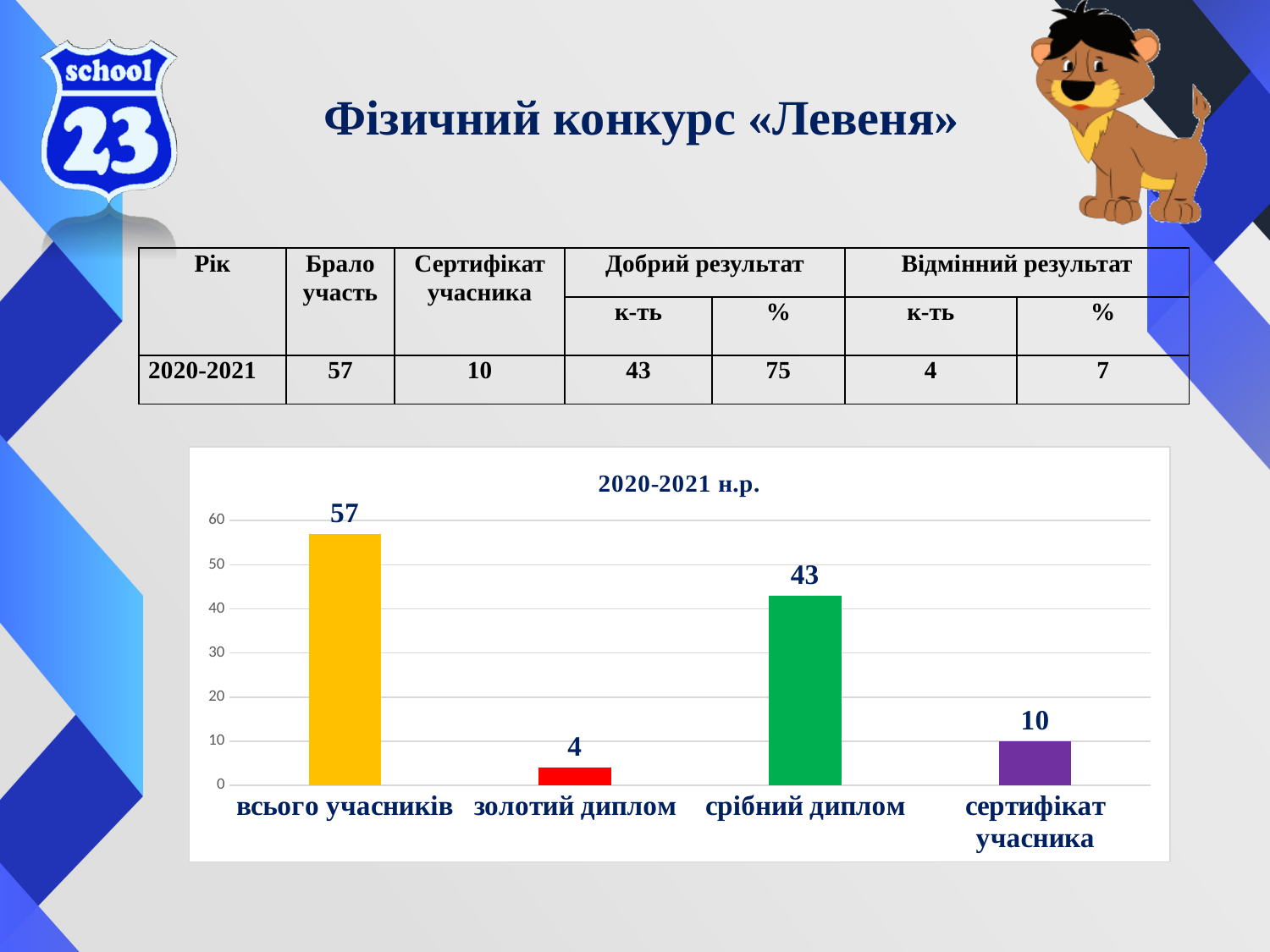
What is the difference between the values for всього учасників and срібний диплом? 14 What is the title of the chart? 2020-2021 н.р. How many categories are shown in the chart? 4 What is the value for срібний диплом in the chart? 43 Which is larger, the value for срібний диплом or the value for сертифікат учасника? срібний диплом What is the value for золотий диплом in the chart? 4 Which category has the lowest value in the chart? золотий диплом What is the value for сертифікат учасника in the chart? 10 What is the difference between the values for сертифікат учасника and золотий диплом? 6 What kind of chart is shown on the slide? bar chart Which category has the highest value in the chart? всього учасників What is the value for всього учасників in the chart? 57